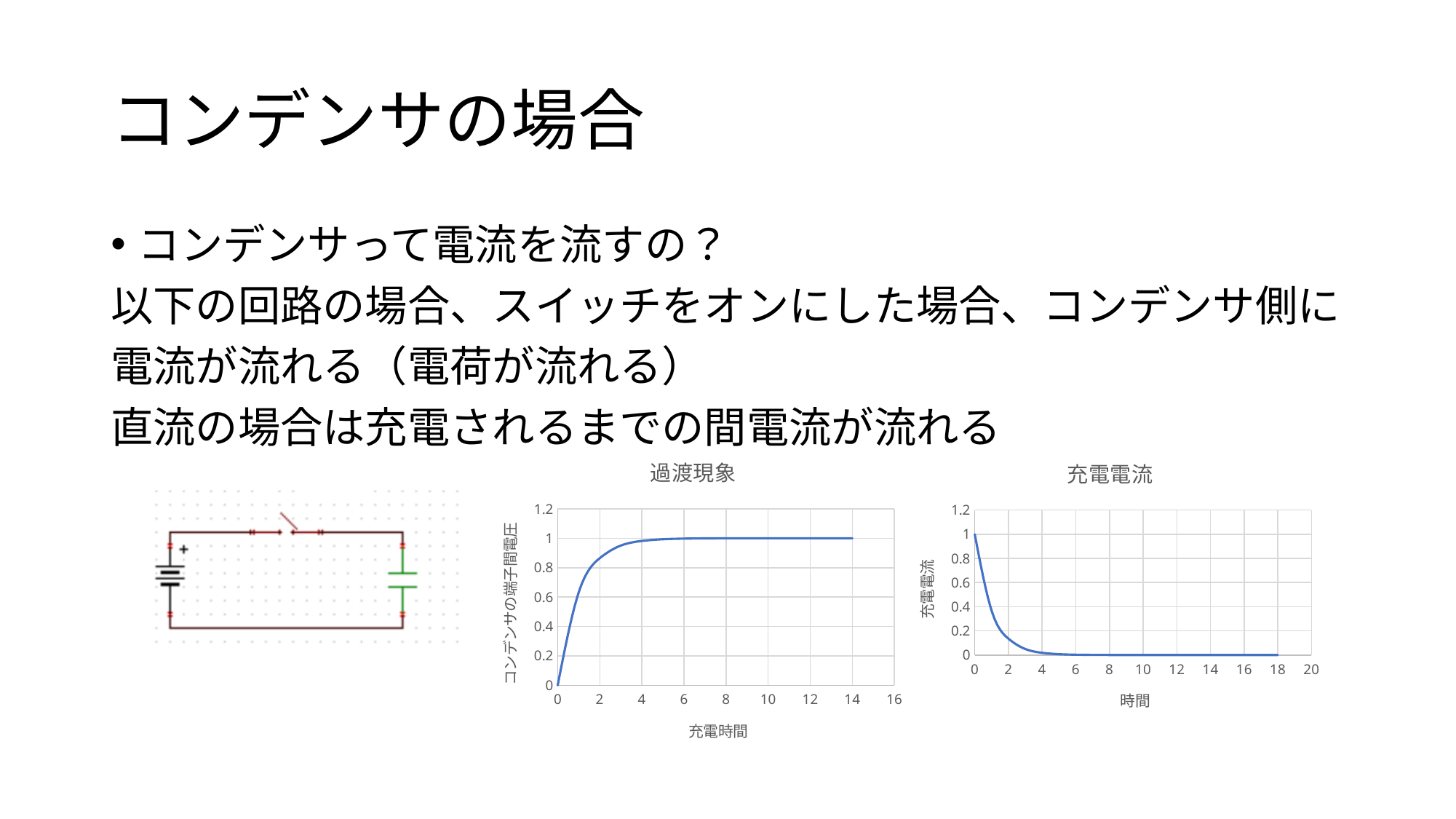
What is the y-axis label of the chart titled 過渡現象? コンデンサの端子間電圧 In the chart titled 過渡現象, is the value at 充電時間 2 greater or less than 0.6? greater What type of chart is the chart titled 充電電流? line chart In the chart titled 過渡現象, what is the value of コンデンサの端子間電圧 at 充電時間 0? 0 What type of chart is the chart titled 過渡現象? line chart In the chart titled 過渡現象, does the plotted value rise or fall as 充電時間 increases? rise In the chart titled 充電電流, is the value at 時間 2 greater or less than 0.4? less In the chart titled 充電電流, does the plotted value rise or fall as 時間 increases? fall In the chart titled 過渡現象, is the value at 充電時間 1 greater or less than 0.4? greater In the chart titled 充電電流, what is the value of 充電電流 at 時間 0? 1 What is the x-axis label of the chart titled 過渡現象? 充電時間